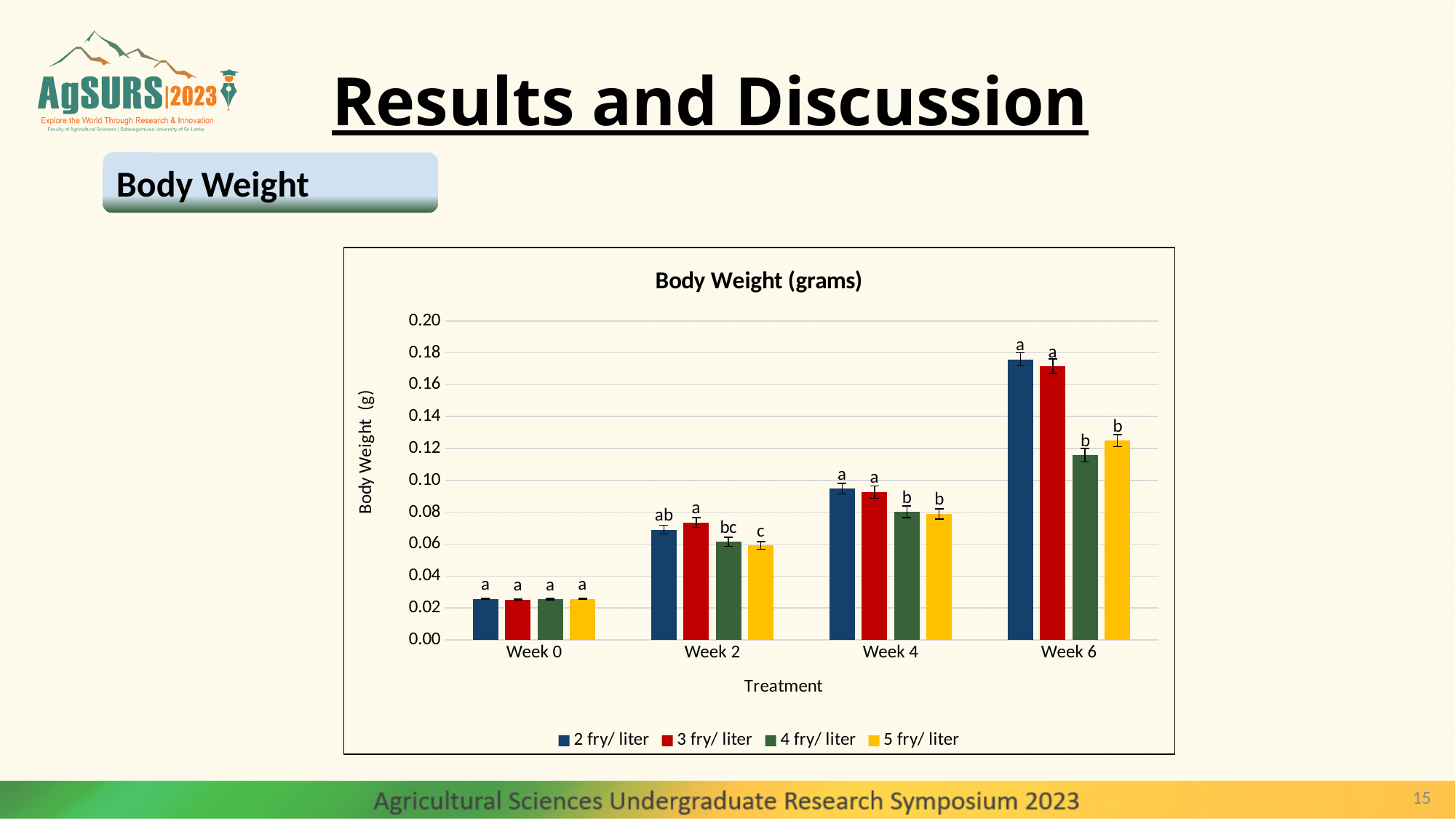
At Week 6, which is larger: the value for 2 fry/ liter or the value for 4 fry/ liter? 2 fry/ liter Is the value for 5 fry/ liter at Week 2 greater or less than 0.08? less What kind of chart is shown on the slide? bar chart Is the value for 2 fry/ liter at Week 4 greater or less than 0.08? greater How many series does the legend of the Body Weight (grams) chart list? 4 How many week categories are shown on the x axis of the chart? 4 What is the title of the chart? Body Weight (grams) Is the value for 2 fry/ liter at Week 6 greater or less than 0.16? greater For the 2 fry/ liter series, which week has the highest body weight? Week 6 At Week 6, which series has the lowest body weight? 4 fry/ liter Do the values for 3 fry/ liter rise or fall from Week 0 to Week 6? rise